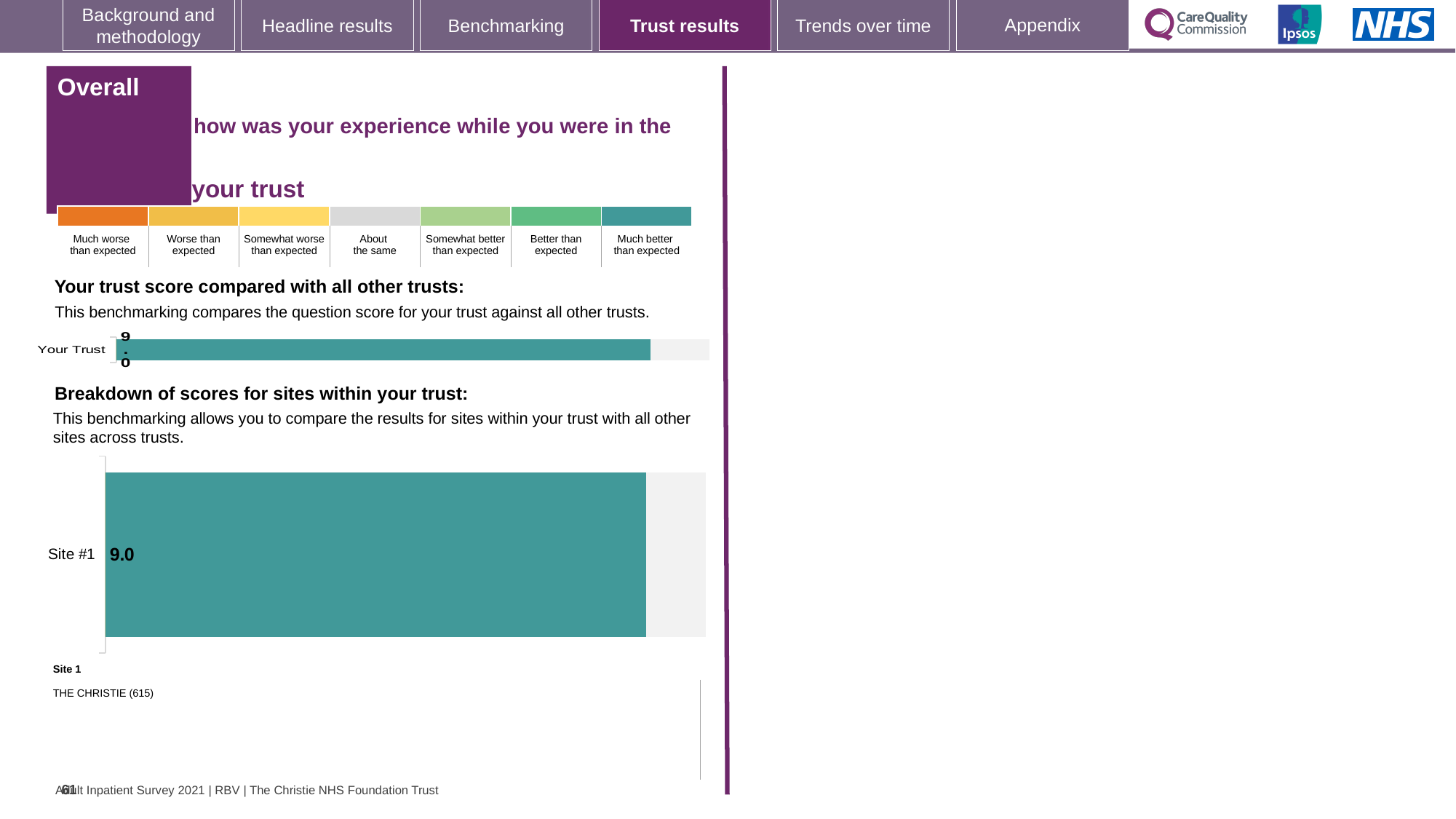
How many bars are plotted in the 'Breakdown of scores for sites within your trust' chart? 1 According to the colour key on the slide, which category does the teal colour of the Site #1 bar represent? Much better than expected How many bars are plotted in the 'Your trust score compared with all other trusts' chart? 1 What is the difference between the Your Trust score and the Site #1 score on the slide? 0.0 What kind of chart is the 'Breakdown of scores for sites within your trust' chart? bar chart In the 'Breakdown of scores for sites within your trust' chart, what is the score for Site #1? 9.0 In the 'Your trust score compared with all other trusts' chart, what is the score for Your Trust? 9.0 Is the score for Your Trust in the 'Your trust score compared with all other trusts' chart the same as the score for Site #1 in the 'Breakdown of scores for sites within your trust' chart? Yes In the 'Breakdown of scores for sites within your trust' chart, what is the name of the site labelled Site 1? THE CHRISTIE (615) What kind of chart is the 'Your trust score compared with all other trusts' chart? bar chart